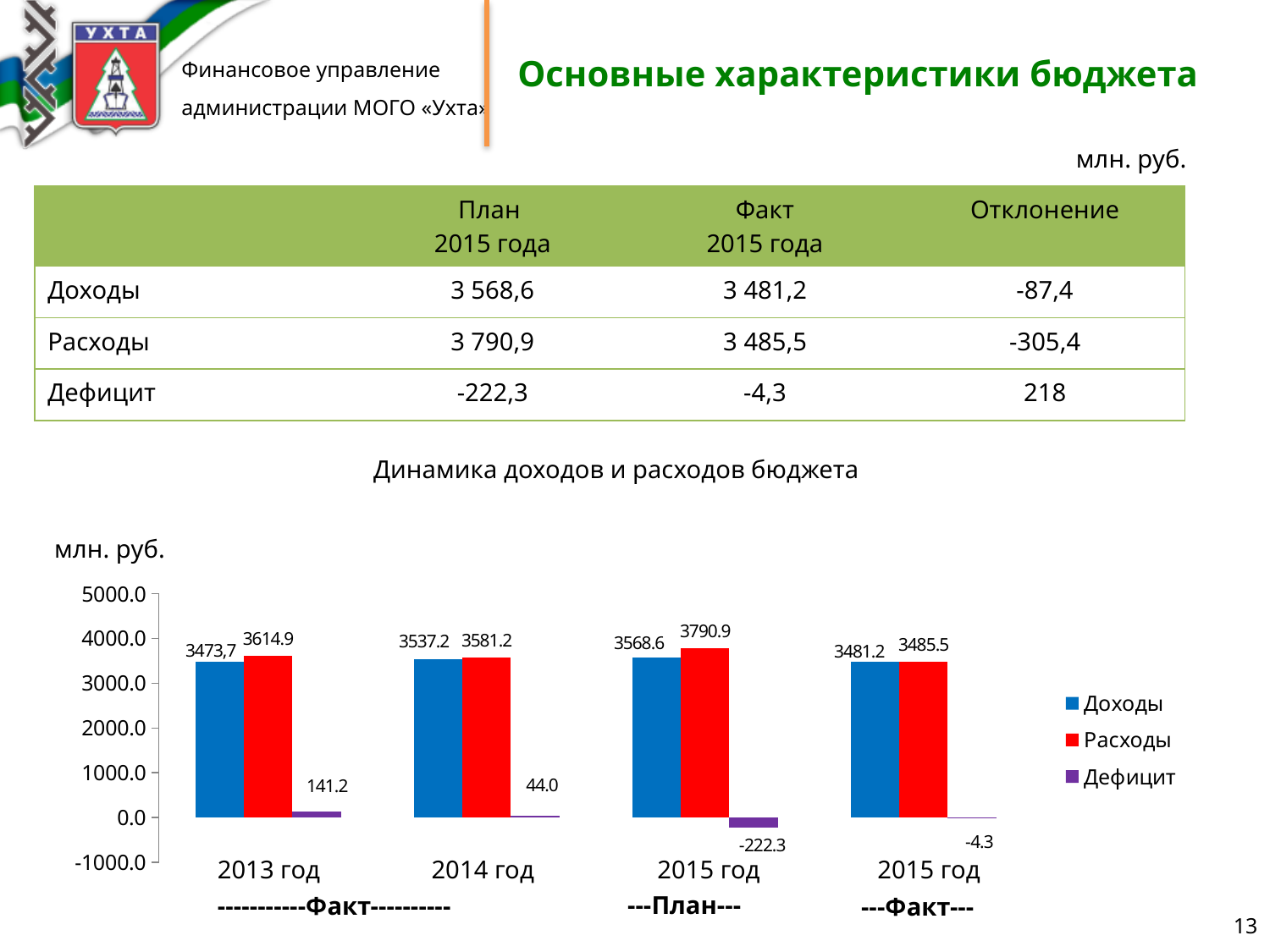
How many categories are shown on the x axis of the chart? 4 Which is larger for 2013 год: Доходы or Расходы? Расходы What is the value of Доходы for 2014 год in the chart? 3537.2 What is the value of Дефицит for 2015 год (Факт) in the chart? -4.3 In which category is Расходы the highest? 2015 год (План) What kind of chart is shown on the slide? bar chart What is the difference between Расходы and Доходы for 2015 год (План)? 222.3 What is the value of Расходы for 2015 год (План) in the chart? 3790.9 In which category is Дефицит the lowest? 2015 год (План) What is the value of Дефицит for 2013 год in the chart? 141.2 How many series does the chart legend list? 3 What is the title of the chart? Динамика доходов и расходов бюджета